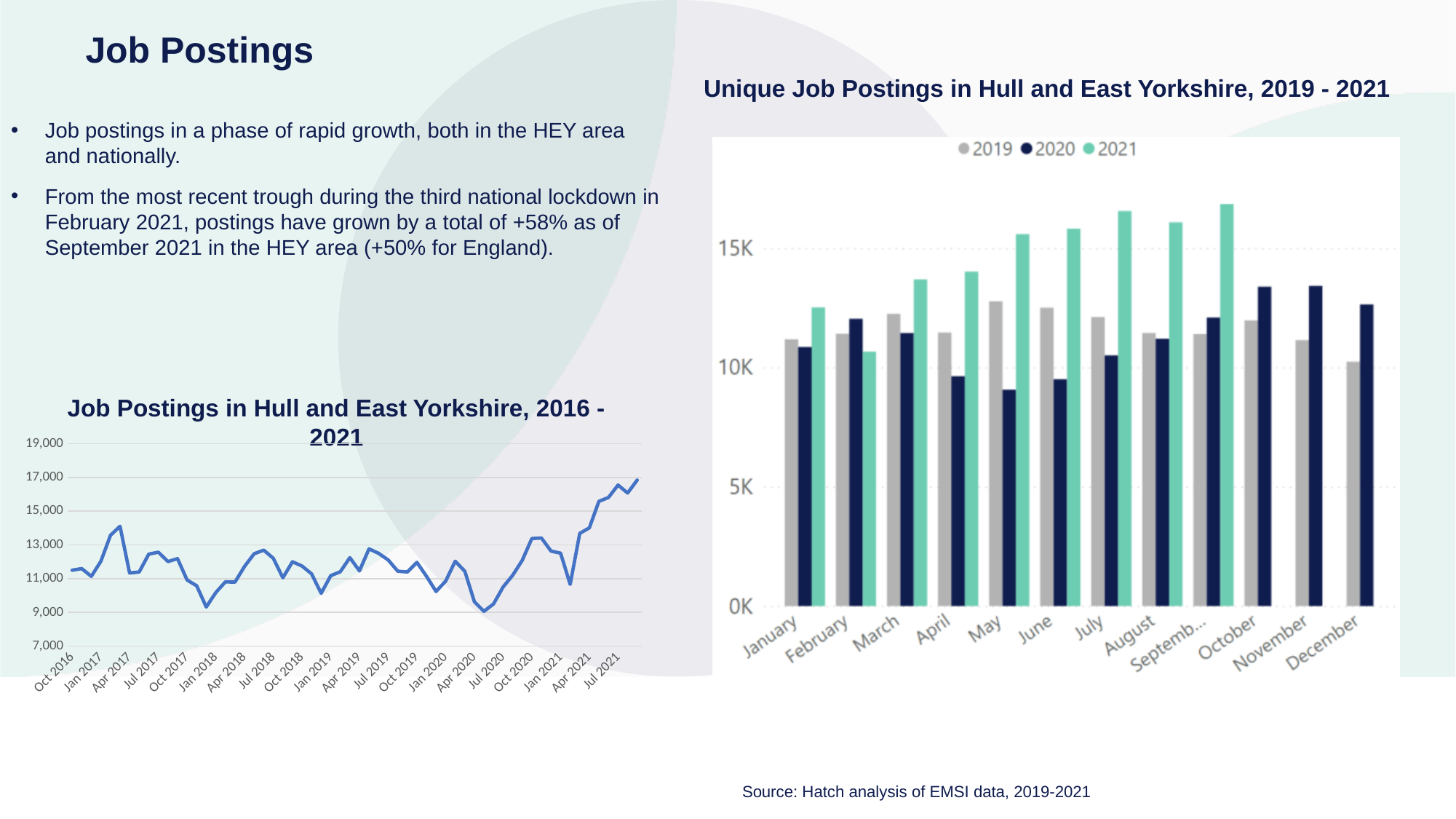
In the 'Unique Job Postings in Hull and East Yorkshire, 2019 - 2021' chart, which is larger for November: the 2019 value or the 2020 value? 2020 How many months are shown on the x axis of the 'Unique Job Postings in Hull and East Yorkshire, 2019 - 2021' chart? 12 What kind of chart is the 'Job Postings in Hull and East Yorkshire, 2016 - 2021' chart on the left? line chart In the 'Unique Job Postings in Hull and East Yorkshire, 2019 - 2021' chart, is the 2021 value for September greater or less than 15K? greater What kind of chart is the 'Unique Job Postings in Hull and East Yorkshire, 2019 - 2021' chart on the right? bar chart In the 'Job Postings in Hull and East Yorkshire, 2016 - 2021' chart, is the value for Jul 2021 greater or less than 15,000? greater How many series does the legend of the 'Unique Job Postings in Hull and East Yorkshire, 2019 - 2021' chart list? 3 In the 'Unique Job Postings in Hull and East Yorkshire, 2019 - 2021' chart, which month has the highest 2019 value? May In the 'Job Postings in Hull and East Yorkshire, 2016 - 2021' chart, do the values rise or fall between Jan 2021 and Jul 2021? rise In the 'Unique Job Postings in Hull and East Yorkshire, 2019 - 2021' chart, is the 2020 value for May greater or less than 10K? less In the 'Unique Job Postings in Hull and East Yorkshire, 2019 - 2021' chart, which month has the lowest 2021 value? February In the 'Unique Job Postings in Hull and East Yorkshire, 2019 - 2021' chart, which month has the lowest 2020 value? May